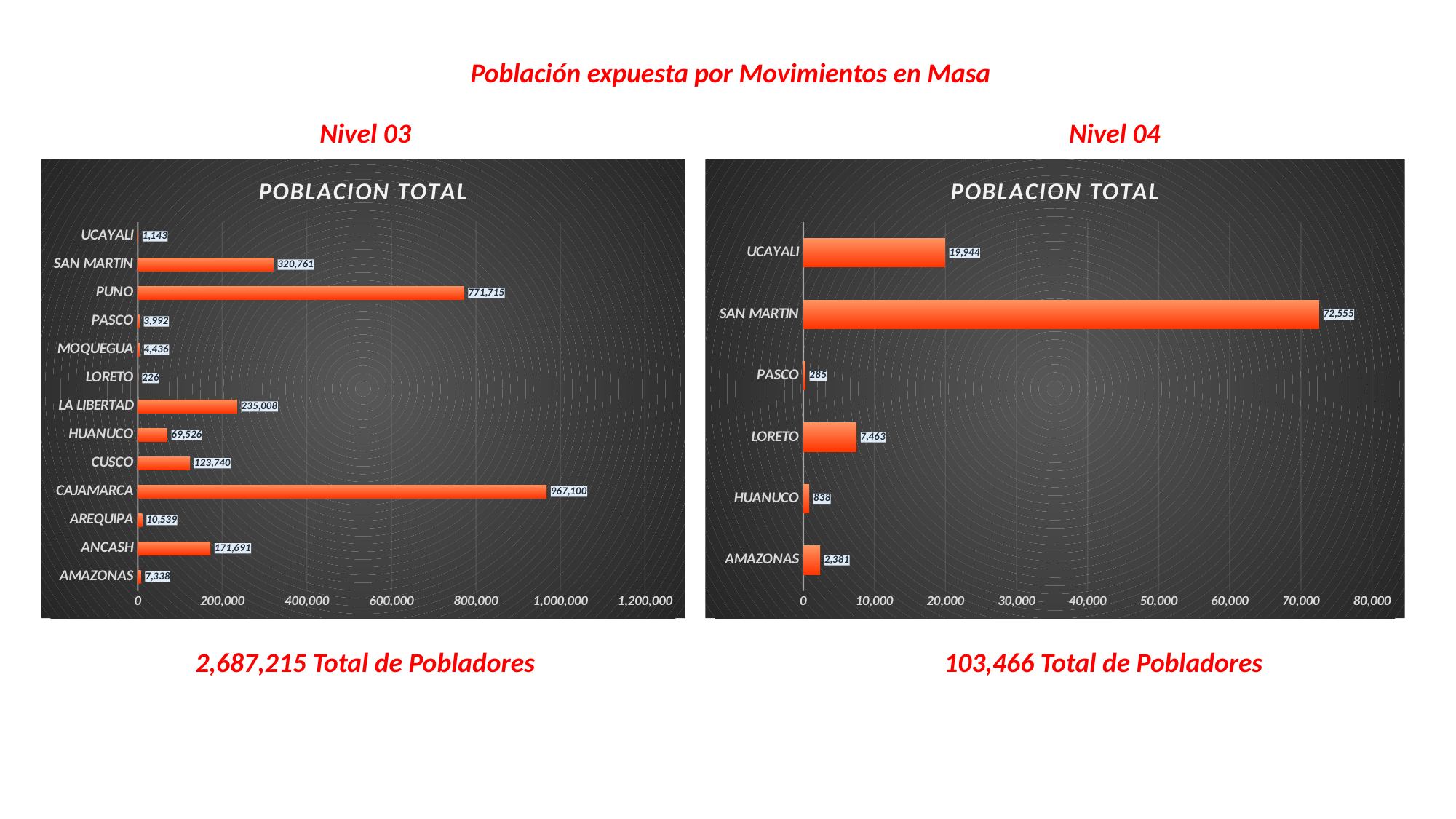
In the Nivel 03 chart, what is the value for CAJAMARCA? 967,100 In the Nivel 03 chart, what is the difference between CAJAMARCA and PUNO? 195,385 In the Nivel 04 chart, is the value for SAN MARTIN greater or less than 70,000? greater In the Nivel 03 chart, which region has the lowest population? LORETO What type of chart is the Nivel 04 chart? Bar chart How many regions are shown in the Nivel 04 chart? 6 How many regions are shown in the Nivel 03 chart? 13 In the Nivel 04 chart, what is the value for LORETO? 7,463 In the Nivel 04 chart, what is the difference between SAN MARTIN and UCAYALI? 52,611 In the Nivel 03 chart, which is larger, LA LIBERTAD or ANCASH? LA LIBERTAD In the Nivel 03 chart, which region has the highest population? CAJAMARCA In the Nivel 04 chart, which region has the lowest population? PASCO